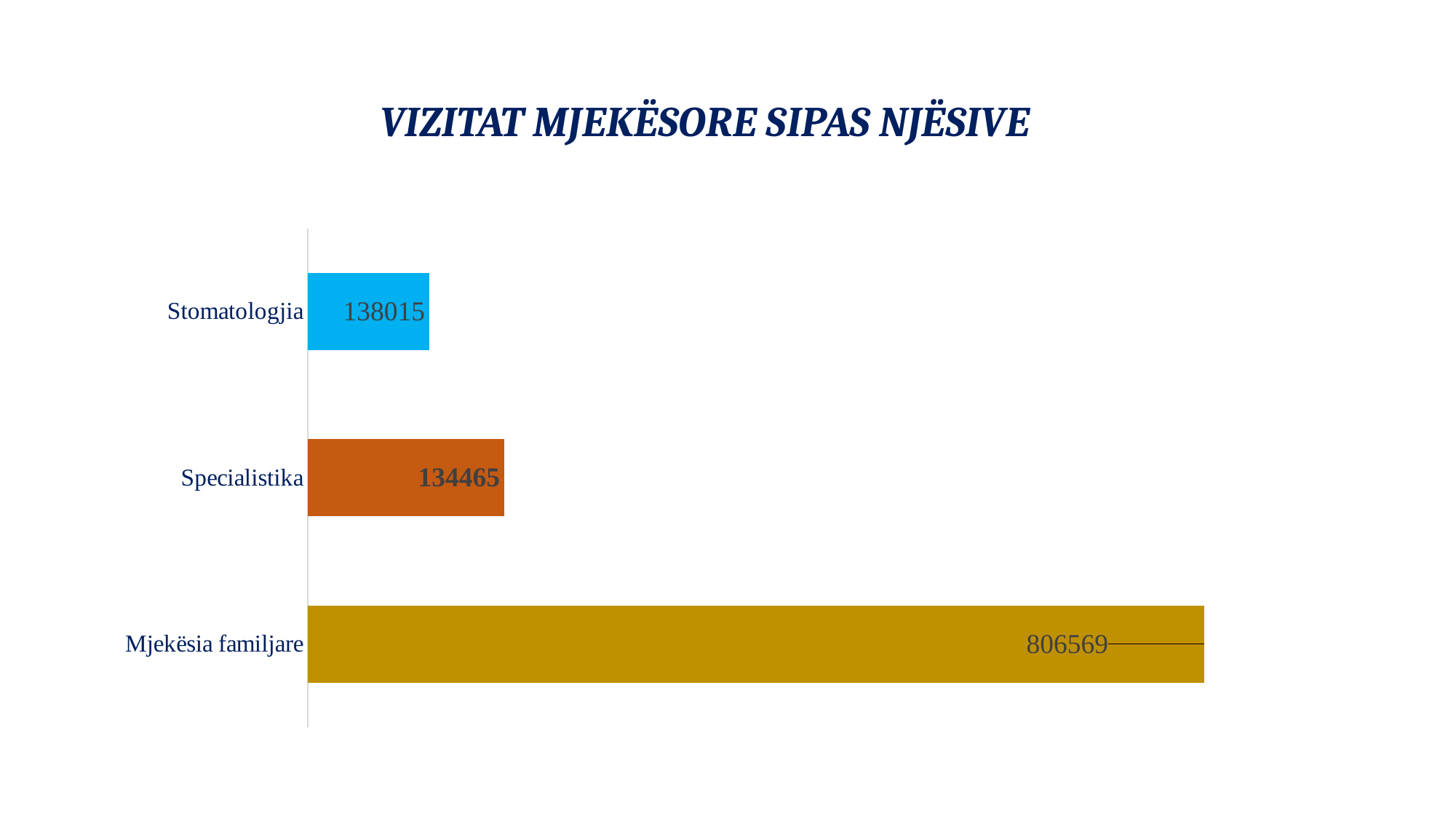
How many categories are shown in the chart? 3 Which category has the highest value? Mjekësia familjare What colour is the bar for Mjekësia familjare? Gold Which is larger, the value for Mjekësia familjare or the value for Specialistika? Mjekësia familjare What is the value for Specialistika? 134465 What is the value for Mjekësia familjare? 806569 What is the title of the chart? VIZITAT MJEKËSORE SIPAS NJËSIVE What is the difference between the values for Mjekësia familjare and Specialistika? 672104 Which is larger, the value for Mjekësia familjare or the value for Stomatologjia? Mjekësia familjare What is the value for Stomatologjia? 138015 What is the difference between the values for Mjekësia familjare and Stomatologjia? 668554 What kind of chart is shown on the slide? Bar chart